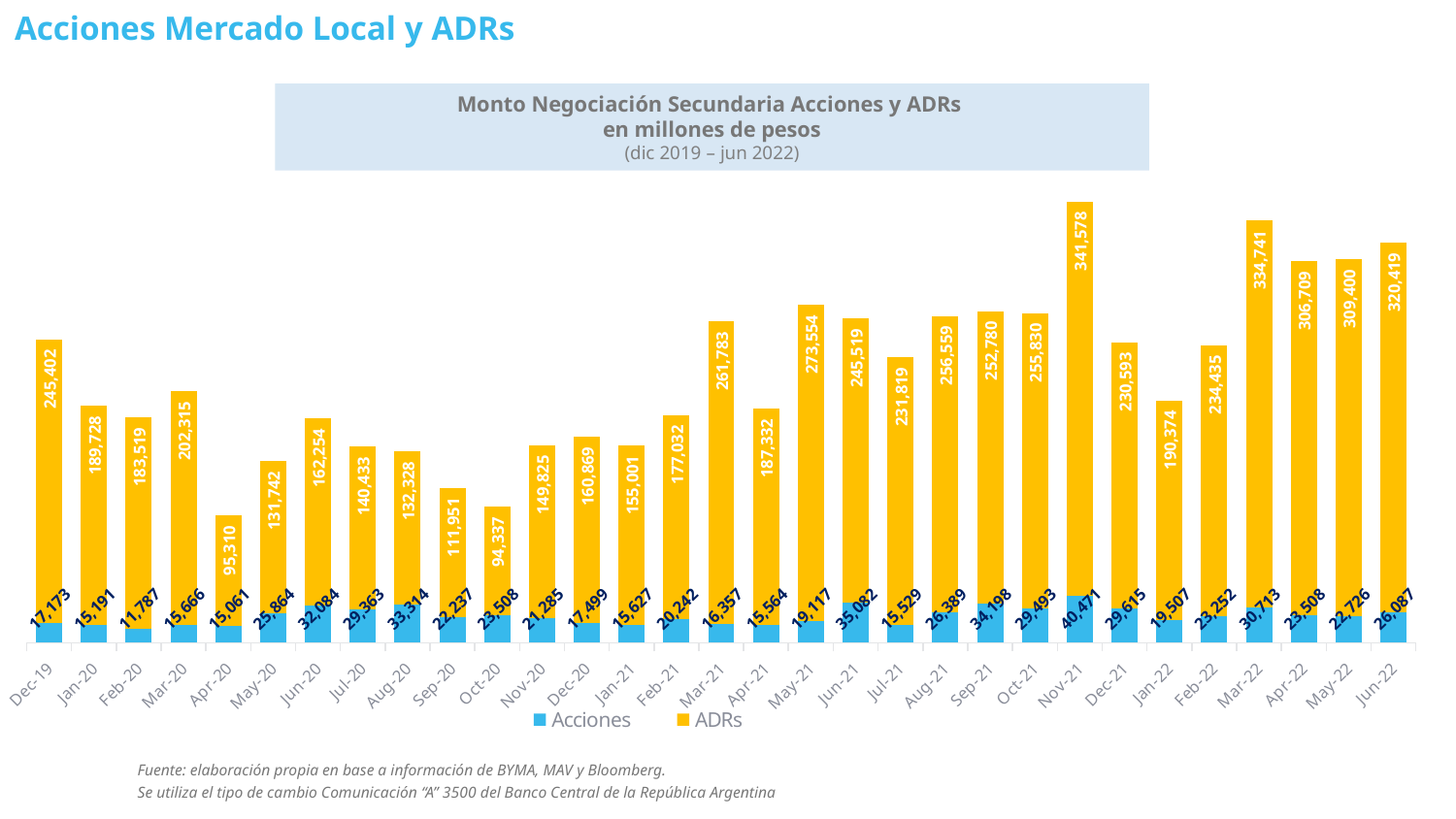
Which month has the lowest Acciones value? Feb-20 What is the total of the stacked bar for Nov-21? 382,049 Which is larger, the ADRs value for Dec-19 or for Jun-21? Jun-21 What is the ADRs value for Apr-20? 95,310 How many months are shown on the x axis? 31 Which month has the lowest ADRs value? Oct-20 What is the difference between the ADRs values for Nov-21 and Mar-22? 6,837 How many series does the legend list? 2 What is the Acciones value for Jun-20? 32,084 What kind of chart is shown? Stacked bar chart Which month has the highest ADRs value? Nov-21 What is the ADRs value for Nov-21? 341,578